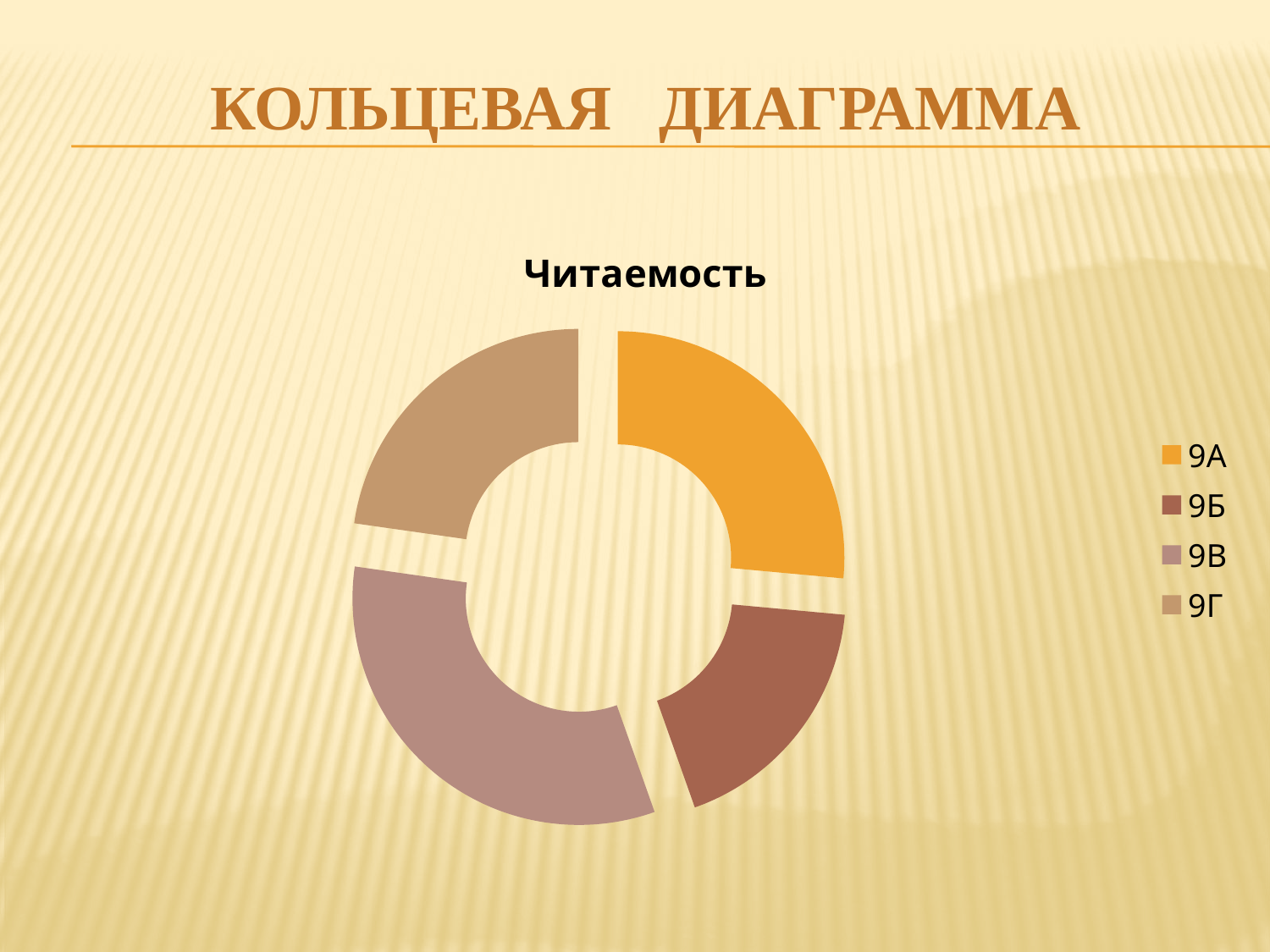
Which slice is larger, 9А or 9Б? 9А How many categories does the chart show? 4 What kind of chart is shown on the slide? doughnut chart Which category has the largest slice in the chart? 9В Which slice is larger, 9В or 9Б? 9В Which category has the smallest slice in the chart? 9Б Which colour represents 9А in the chart? orange What is the title of the chart? Читаемость How many entries does the legend list? 4